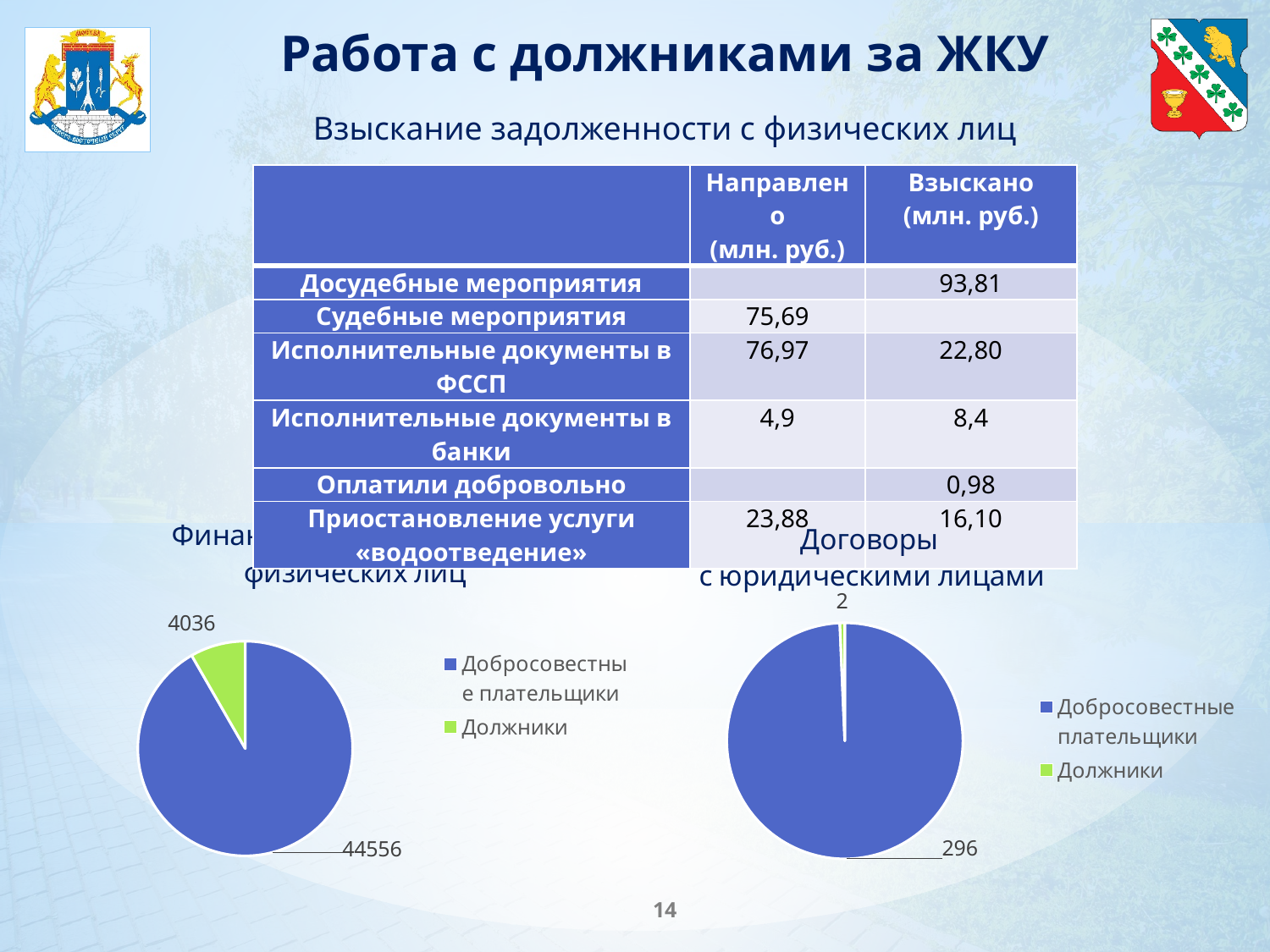
On the left pie chart, what colour is the slice for Должники? Green On the left pie chart, what is the difference between the values for Добросовестные плательщики and Должники? 40520 What type of chart is the chart titled «Договоры с юридическими лицами»? Pie chart On the left pie chart, what is the value for Должники? 4036 On the left pie chart, what is the value for Добросовестные плательщики? 44556 On the pie chart titled «Договоры с юридическими лицами», what is the value for Должники? 2 On the pie chart titled «Договоры с юридическими лицами», what is the value for Добросовестные плательщики? 296 On the left pie chart, which category has the largest slice? Добросовестные плательщики On the pie chart titled «Договоры с юридическими лицами», which category has the smallest slice? Должники On the pie chart titled «Договоры с юридическими лицами», what is the total of the two slices? 298 On the left pie chart, which is larger: Добросовестные плательщики or Должники? Добросовестные плательщики How many slices does the pie chart titled «Договоры с юридическими лицами» have? 2